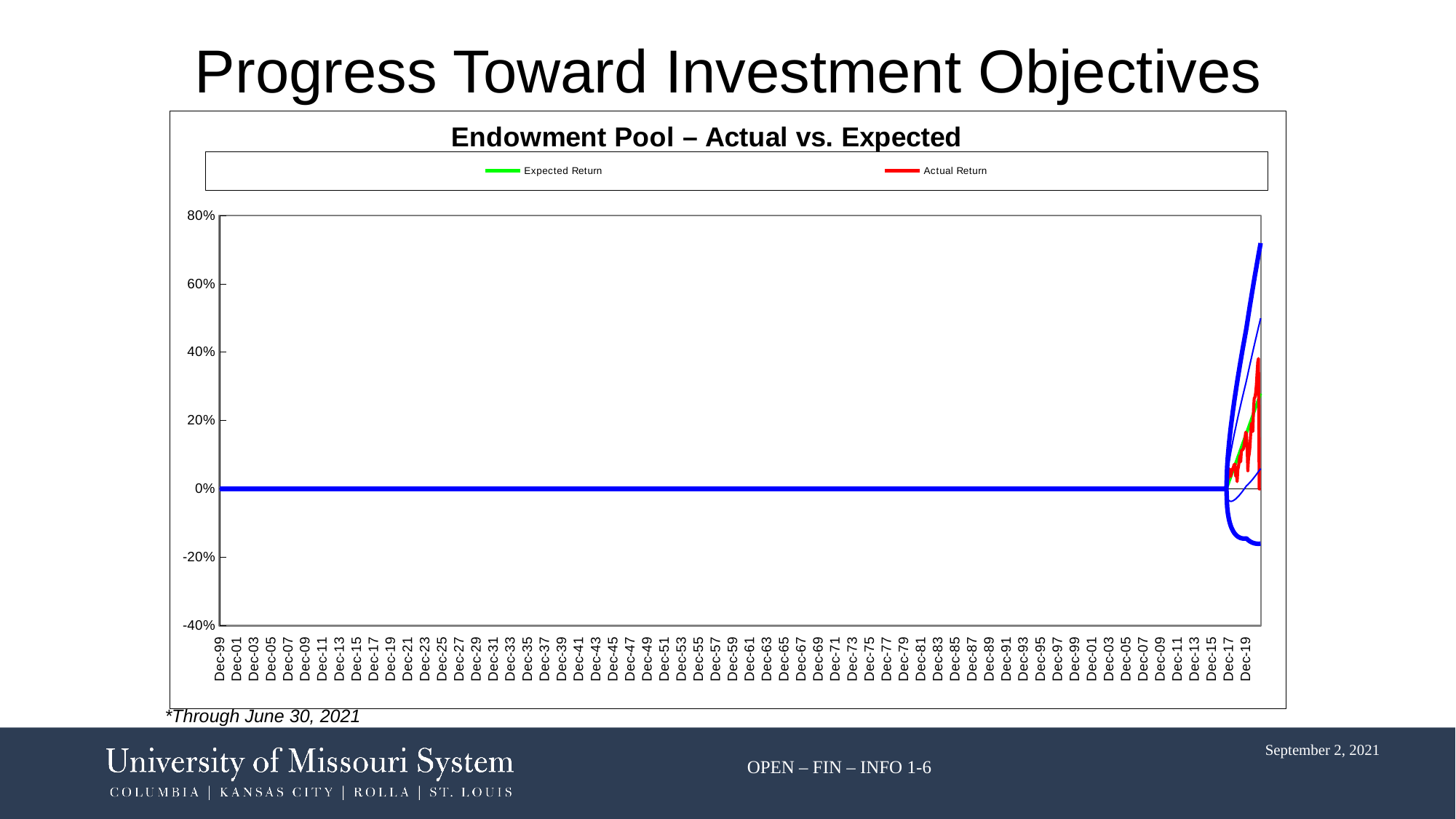
Which colour represents the Actual Return series in the legend? red Is the lowest point of the Actual Return line greater or less than -20%? greater What kind of chart is shown on the slide? line chart Is the highest point of the Actual Return line greater or less than 20%? greater What is the title of the chart? Endowment Pool – Actual vs. Expected How many series does the legend of the chart list? 2